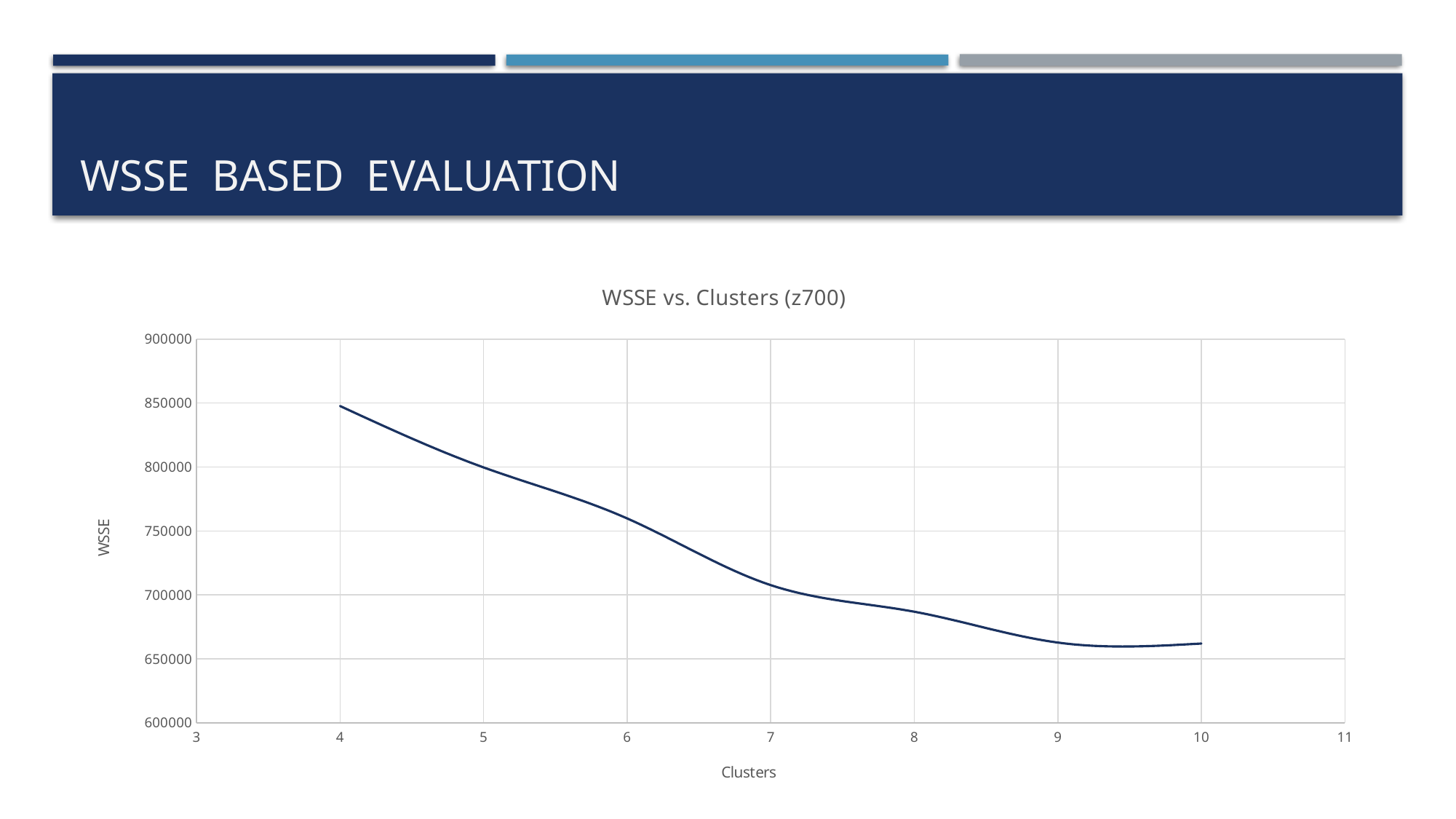
Is the WSSE value at 10 clusters greater or less than 700000? less What is the title of the chart? WSSE vs. Clusters (z700) Is the WSSE value at 6 clusters greater or less than 800000? less Which has the larger WSSE value, 4 clusters or 10 clusters? 4 clusters Is the WSSE value at 5 clusters greater or less than 850000? less Which has the larger WSSE value, 5 clusters or 8 clusters? 5 clusters What kind of chart is shown on the slide? line chart At which number of clusters is WSSE highest? 4 Does WSSE rise or fall as the number of clusters increases from 4 to 10? fall What is the label on the x axis of the chart? Clusters